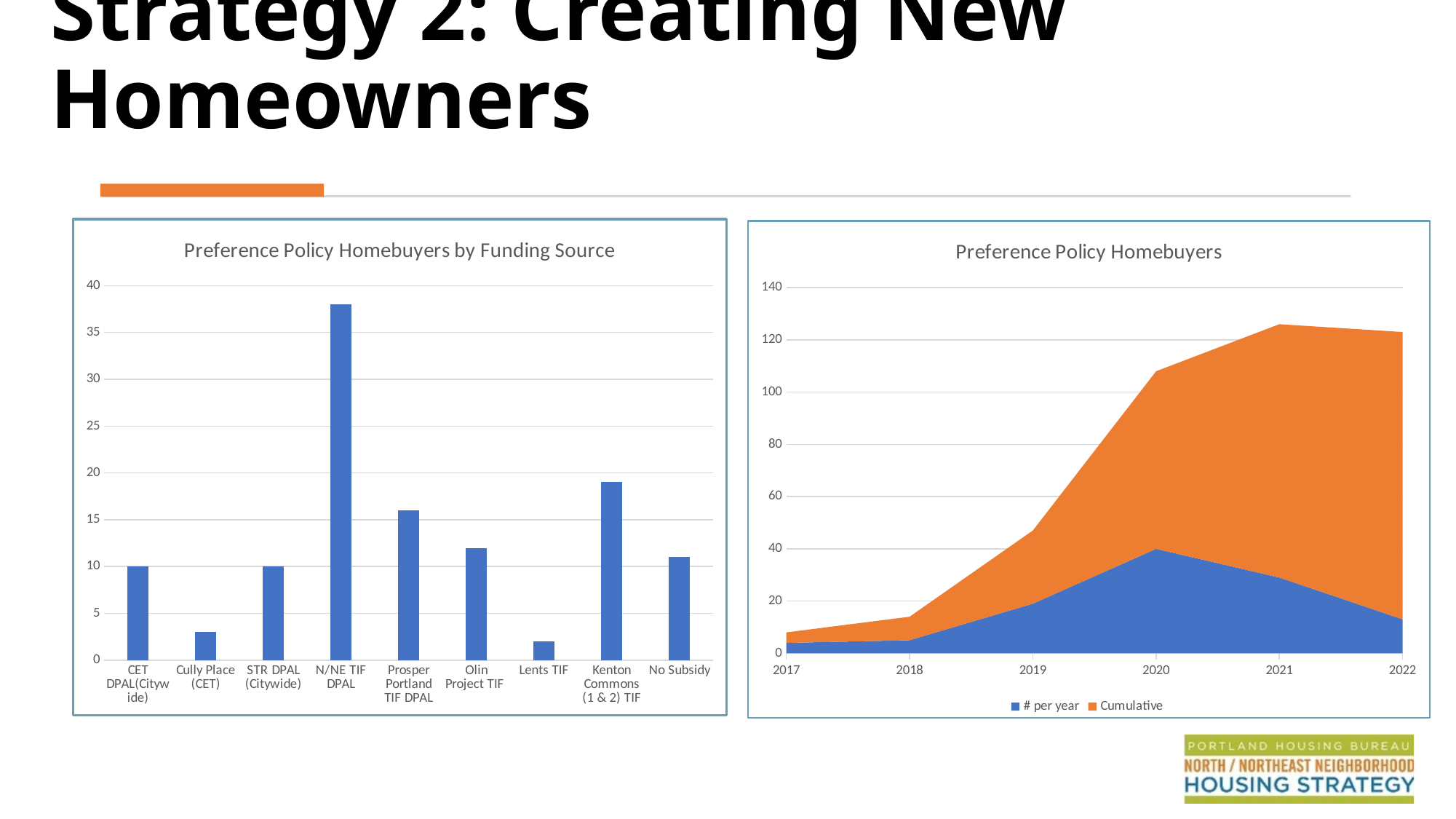
How many series does the legend of the 'Preference Policy Homebuyers' chart list? 2 What kind of chart is the 'Preference Policy Homebuyers by Funding Source' chart? bar chart In the 'Preference Policy Homebuyers by Funding Source' chart, is the value for Lents TIF greater or less than 5? less In the 'Preference Policy Homebuyers' chart, is the '# per year' value for 2020 greater or less than 20? greater How many years are shown on the x axis of the 'Preference Policy Homebuyers' chart? 6 In the 'Preference Policy Homebuyers by Funding Source' chart, is the value for N/NE TIF DPAL greater or less than 35? greater In the 'Preference Policy Homebuyers by Funding Source' chart, which is larger, Kenton Commons (1 & 2) TIF or Prosper Portland TIF DPAL? Kenton Commons (1 & 2) TIF How many funding source categories are shown in the 'Preference Policy Homebuyers by Funding Source' chart? 9 In the 'Preference Policy Homebuyers by Funding Source' chart, which funding source has the highest value? N/NE TIF DPAL In the 'Preference Policy Homebuyers' chart, what colour represents the Cumulative series? orange In the 'Preference Policy Homebuyers by Funding Source' chart, what is the value for CET DPAL(Citywide)? 10 In the 'Preference Policy Homebuyers' chart, does the Cumulative series rise or fall from 2017 to 2021? rise